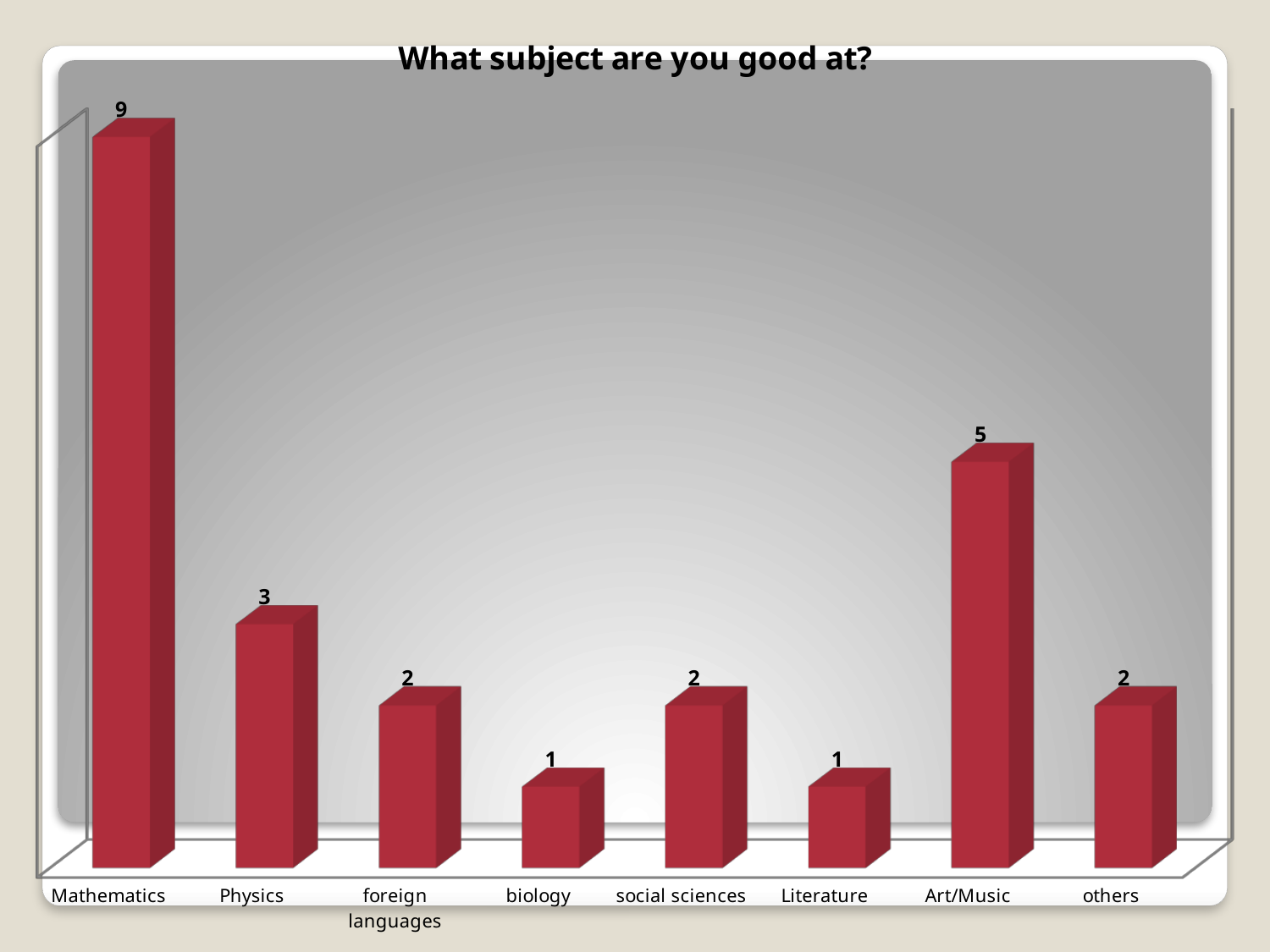
Which is larger, the value for Physics or the value for social sciences? Physics What kind of chart is shown on the slide? bar chart What is the value for Art/Music? 5 What is the value for Literature? 1 What is the value for Mathematics? 9 What is the difference between the values for Mathematics and Art/Music? 4 What is the total of the values for foreign languages, social sciences and others? 6 What is the title of the chart? What subject are you good at? What is the difference between the values for Physics and biology? 2 What is the value for Physics? 3 How many subject categories are shown in the chart? 8 Which subject has the highest value? Mathematics